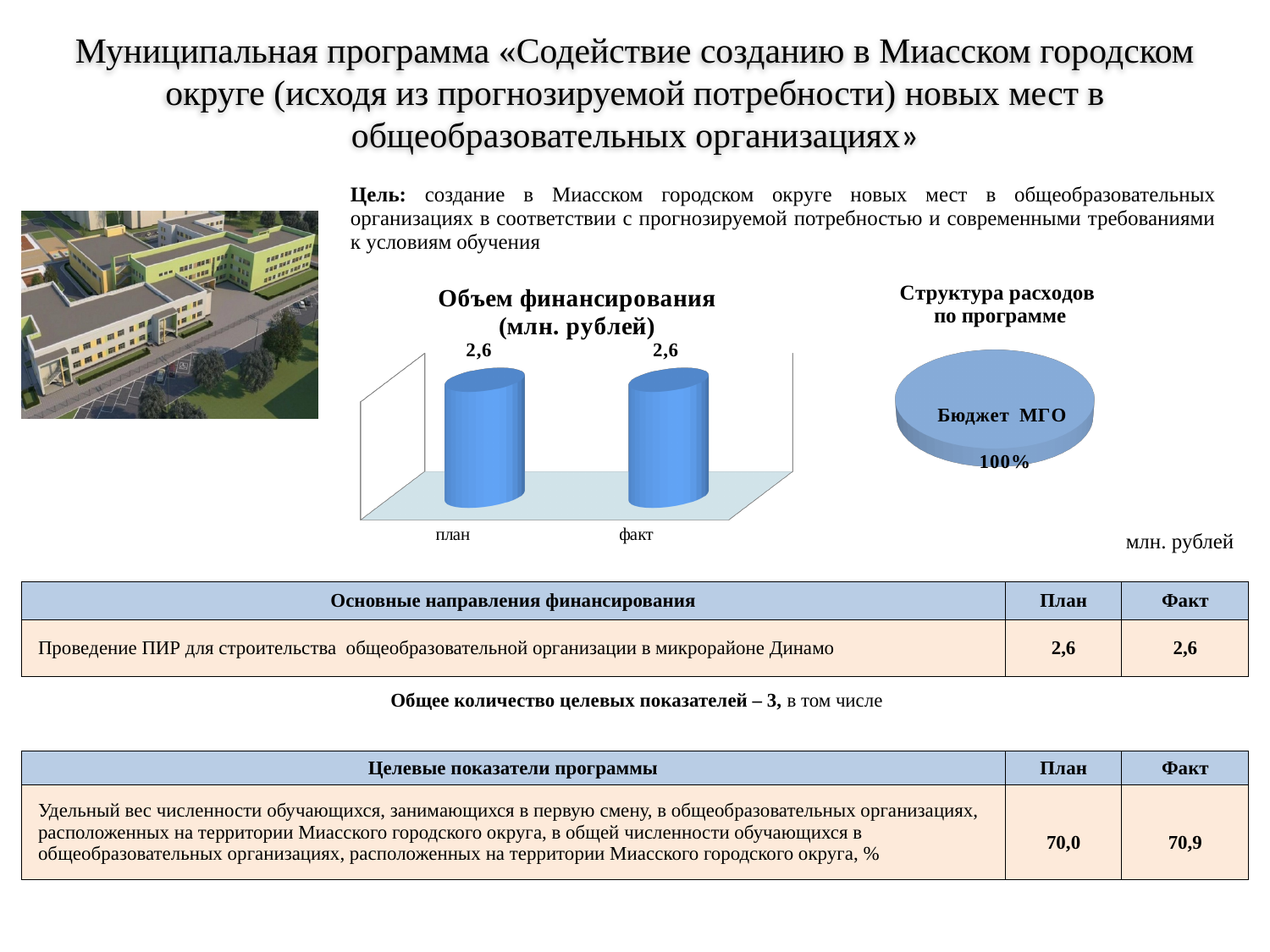
What unit is given in the title of the bar chart 'Объем финансирования'? млн. рублей In the chart 'Объем финансирования (млн. рублей)', what are the category labels on the x axis? план, факт In the pie chart 'Структура расходов по программе', what is the label of the only slice? Бюджет МГО What kind of chart is 'Структура расходов по программе'? pie chart In the chart 'Объем финансирования (млн. рублей)', what is the difference between the план and факт values? 0 In the chart 'Объем финансирования (млн. рублей)', what is the value for факт? 2,6 In the pie chart 'Структура расходов по программе', how many slices are there? 1 In the pie chart 'Структура расходов по программе', what share does 'Бюджет МГО' have? 100% In the chart 'Объем финансирования (млн. рублей)', how many bars are plotted? 2 What kind of chart is 'Объем финансирования (млн. рублей)'? bar chart In the chart 'Объем финансирования (млн. рублей)', what is the value for план? 2,6